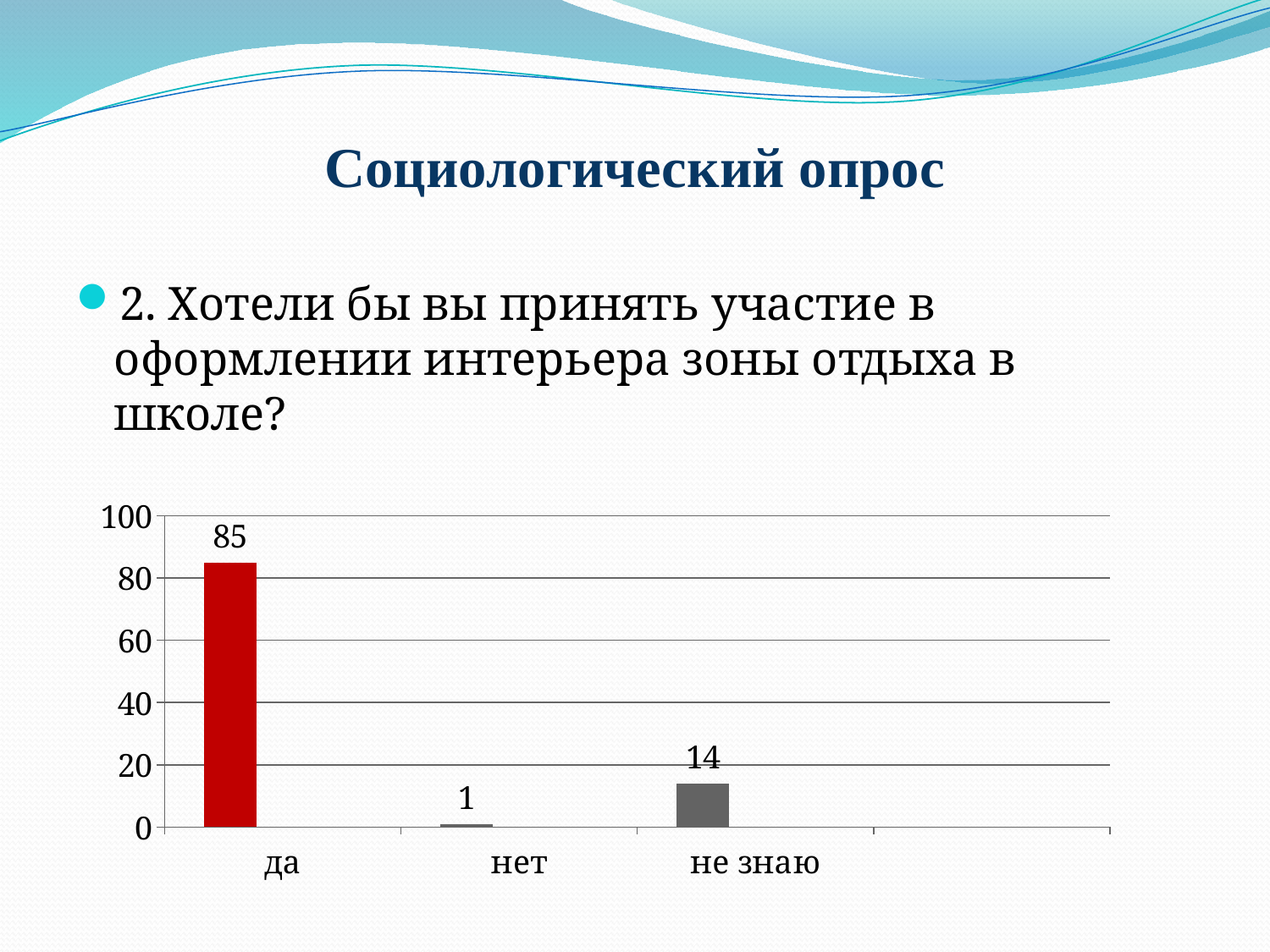
What is the difference between the values for "не знаю" and "нет"? 13 Which is larger, the value for "не знаю" or the value for "нет"? не знаю How many categories are shown on the x axis? 3 What is the value for "да"? 85 Which category has the highest value? да What is the difference between the values for "да" and "не знаю"? 71 What is the value for "нет"? 1 What colour is the bar for "да"? red Is the value for "да" greater or less than 80? greater Which category has the lowest value? нет What kind of chart is shown on the slide? bar chart What is the value for "не знаю"? 14